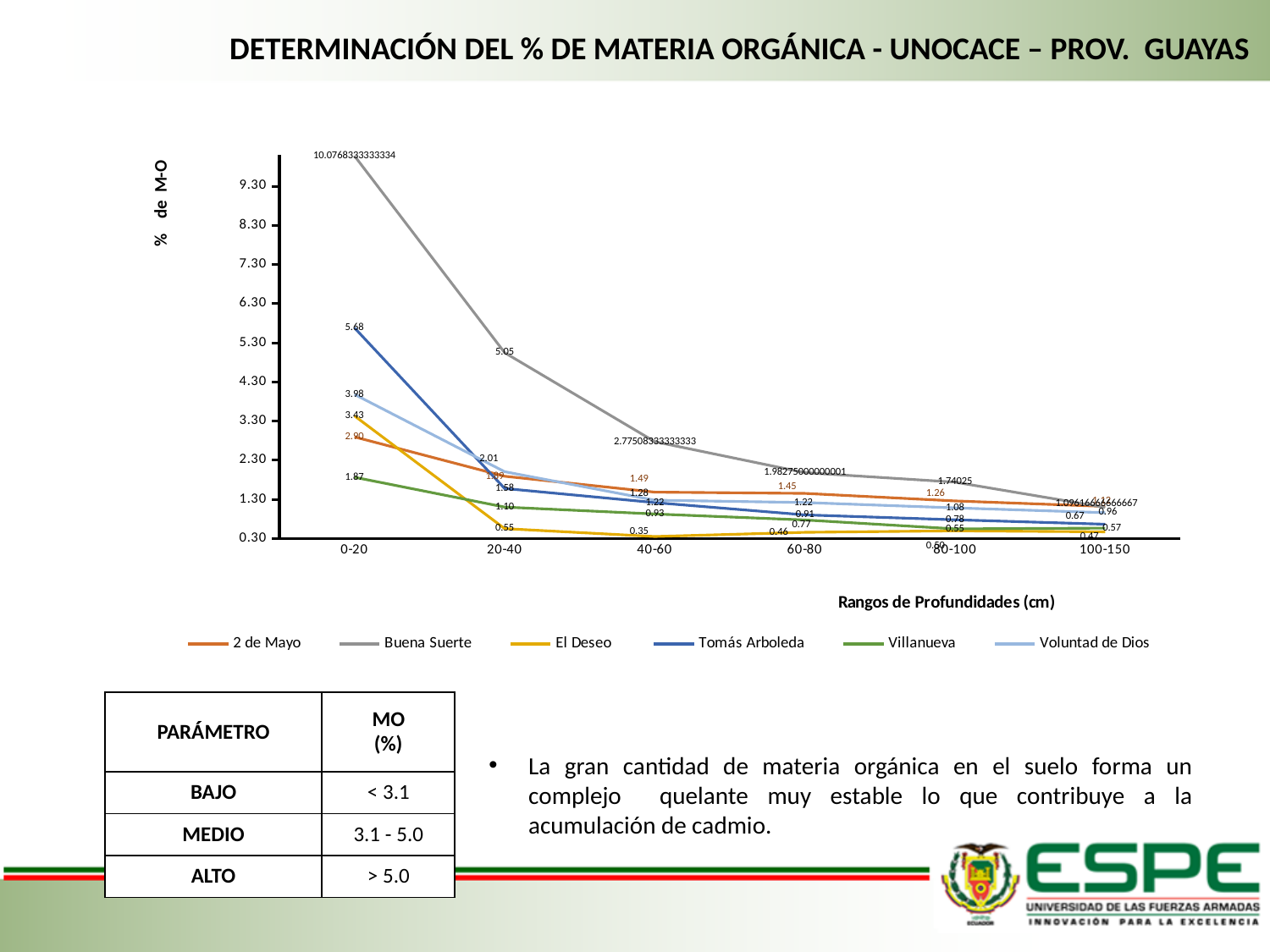
What is the value for El Deseo at the 40-60 depth range? 0.35 What is the value for Tomás Arboleda at the 0-20 depth range? 5.68 What is the value for Buena Suerte at the 20-40 depth range? 5.05 What is the difference between Tomás Arboleda and Villanueva at the 0-20 depth range? 3.81 Which series has the highest value at the 0-20 depth range? Buena Suerte How many series does the legend list? 6 Does the Buena Suerte line rise or fall as depth increases along the x axis? fall What is the title of the x axis? Rangos de Profundidades (cm) What is the value for Buena Suerte at the 0-20 depth range? 10.0768333333334 How many depth ranges are shown on the x axis? 6 Which series has the lowest value at the 0-20 depth range? Villanueva What kind of chart is shown on the slide? line chart